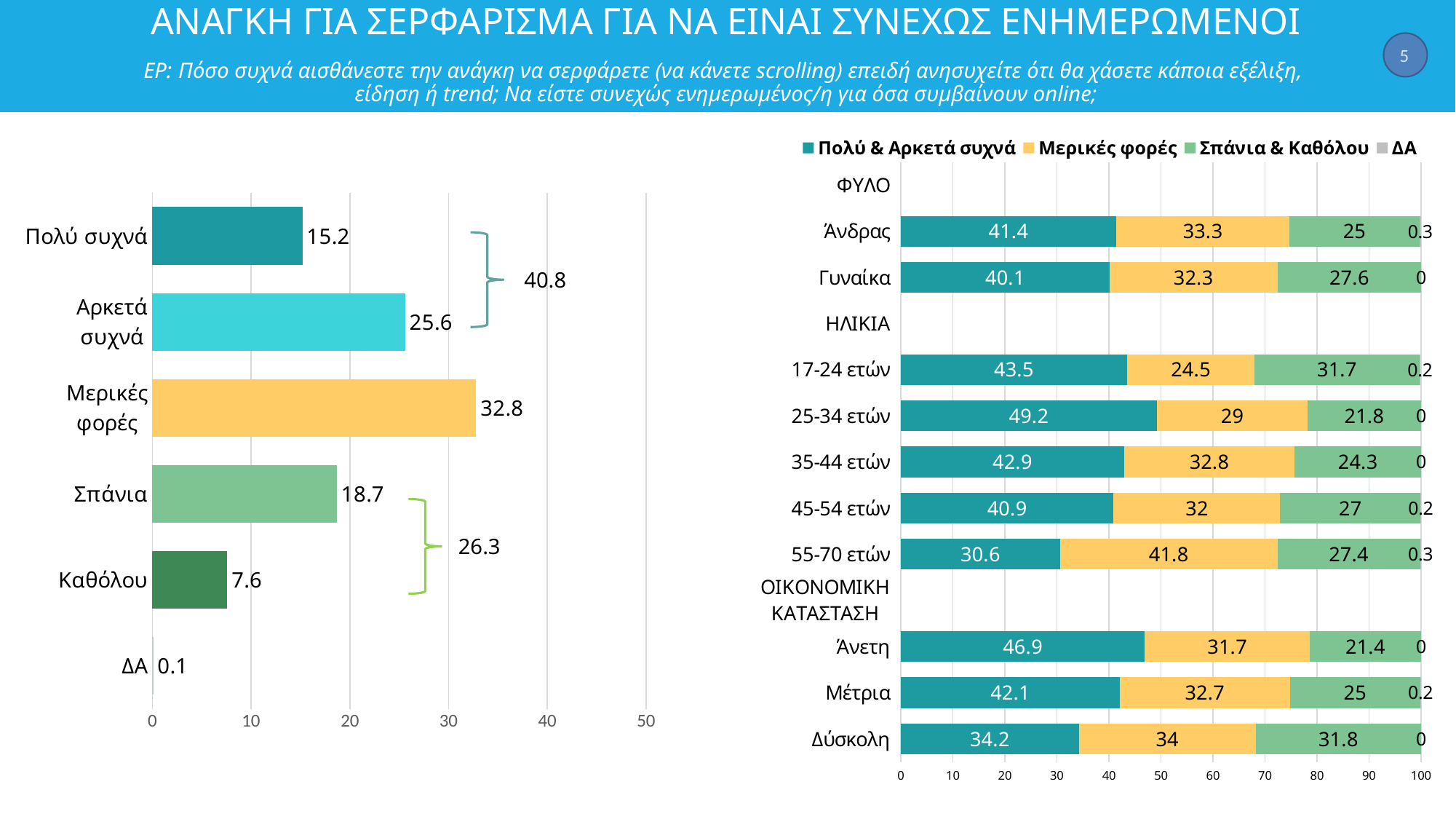
In the right chart, which is larger for Σπάνια & Καθόλου: Άνδρας or Γυναίκα? Γυναίκα In the right chart, which age group has the lowest Πολύ & Αρκετά συχνά value? 55-70 ετών In the right chart, what is the Πολύ & Αρκετά συχνά value for 25-34 ετών? 49.2 In the left chart, what is the value for Μερικές φορές? 32.8 In the left chart, which category has the lowest value? ΔΑ In the right chart, what is the Μερικές φορές value for 55-70 ετών? 41.8 In the left chart, what is the difference between Αρκετά συχνά and Πολύ συχνά? 10.4 In the left chart, how many categories are shown? 6 In the left chart, which category has the highest value? Μερικές φορές In the right chart, how many series does the legend list? 4 In the right chart, what is the difference in Πολύ & Αρκετά συχνά between Άνετη and Δύσκολη? 12.7 What kind of chart is the left chart? Bar chart